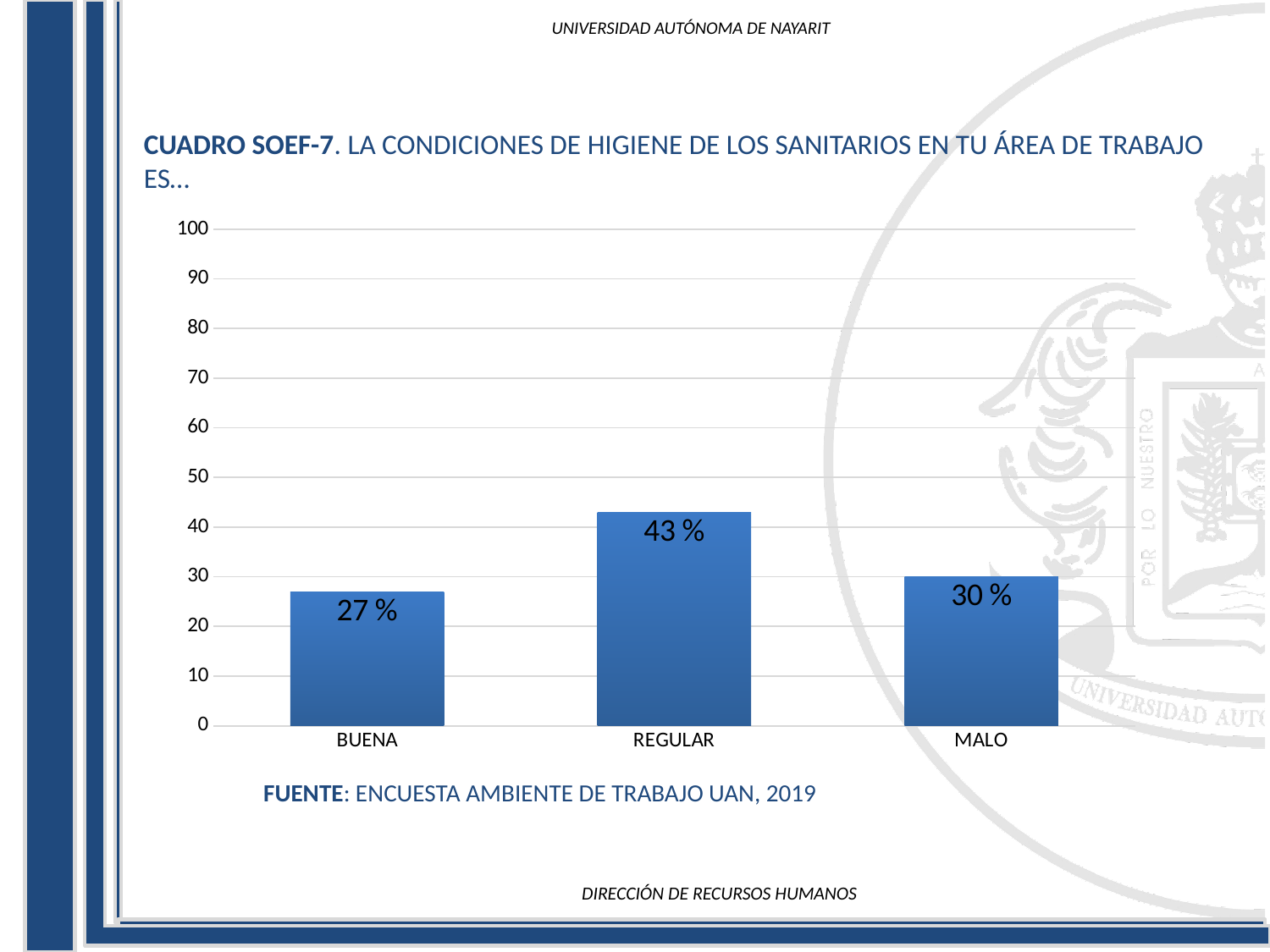
Which category has the highest value? REGULAR What source is cited below the chart? ENCUESTA AMBIENTE DE TRABAJO UAN, 2019 What is the difference between the values for REGULAR and BUENA? 16 % What is the difference between the values for REGULAR and MALO? 13 % What is the value for REGULAR? 43 % Is the value for REGULAR greater or less than 50? less Which is larger, the value for MALO or the value for BUENA? MALO What is the value for BUENA? 27 % How many categories are shown on the x axis? 3 What kind of chart is shown on the slide? bar chart What is the value for MALO? 30 % Which category has the lowest value? BUENA